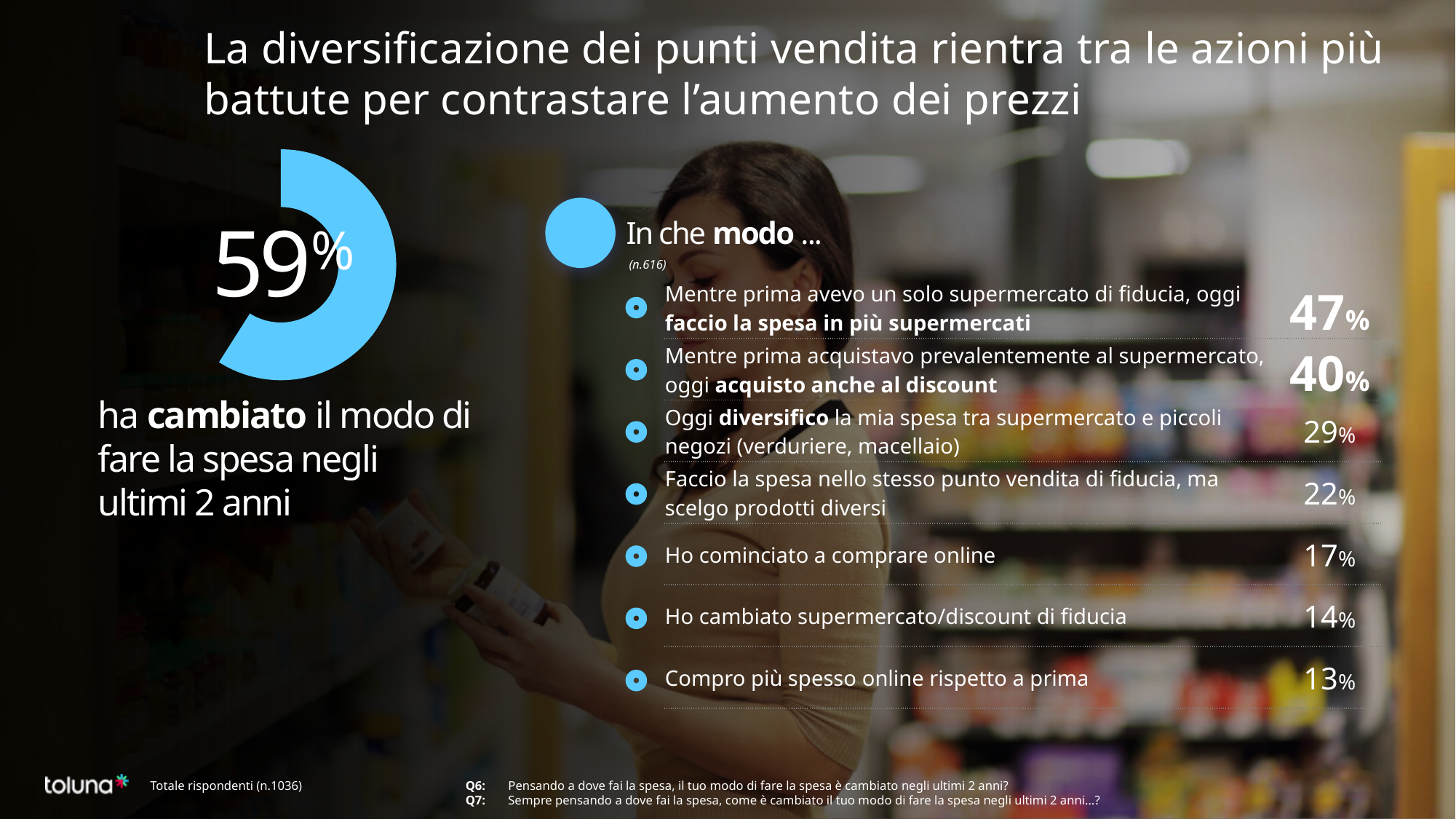
According to the donut chart, what share of respondents changed the way they shop in the last 2 years? 59% In the 'In che modo ...' list, what percentage corresponds to 'Ho cominciato a comprare online'? 17% In the 'In che modo ...' list, what percentage corresponds to 'acquisto anche al discount'? 40% What is the sample size (n) indicated under 'In che modo ...'? n.616 In the 'In che modo ...' list, which item has the highest percentage? faccio la spesa in più supermercati What percentage does the donut chart on the left of the slide show? 59% What kind of chart is shown on the left of the slide next to the text 'ha cambiato il modo di fare la spesa negli ultimi 2 anni'? Donut (pie) chart In the 'In che modo ...' list, what percentage corresponds to 'faccio la spesa in più supermercati'? 47% How many items are listed under 'In che modo ...'? 7 In the 'In che modo ...' list, what is the difference between 'faccio la spesa in più supermercati' (47%) and 'acquisto anche al discount' (40%)? 7% In the 'In che modo ...' list, which item has the lowest percentage? Compro più spesso online rispetto a prima Is the value shown in the donut chart greater or less than 50%? greater